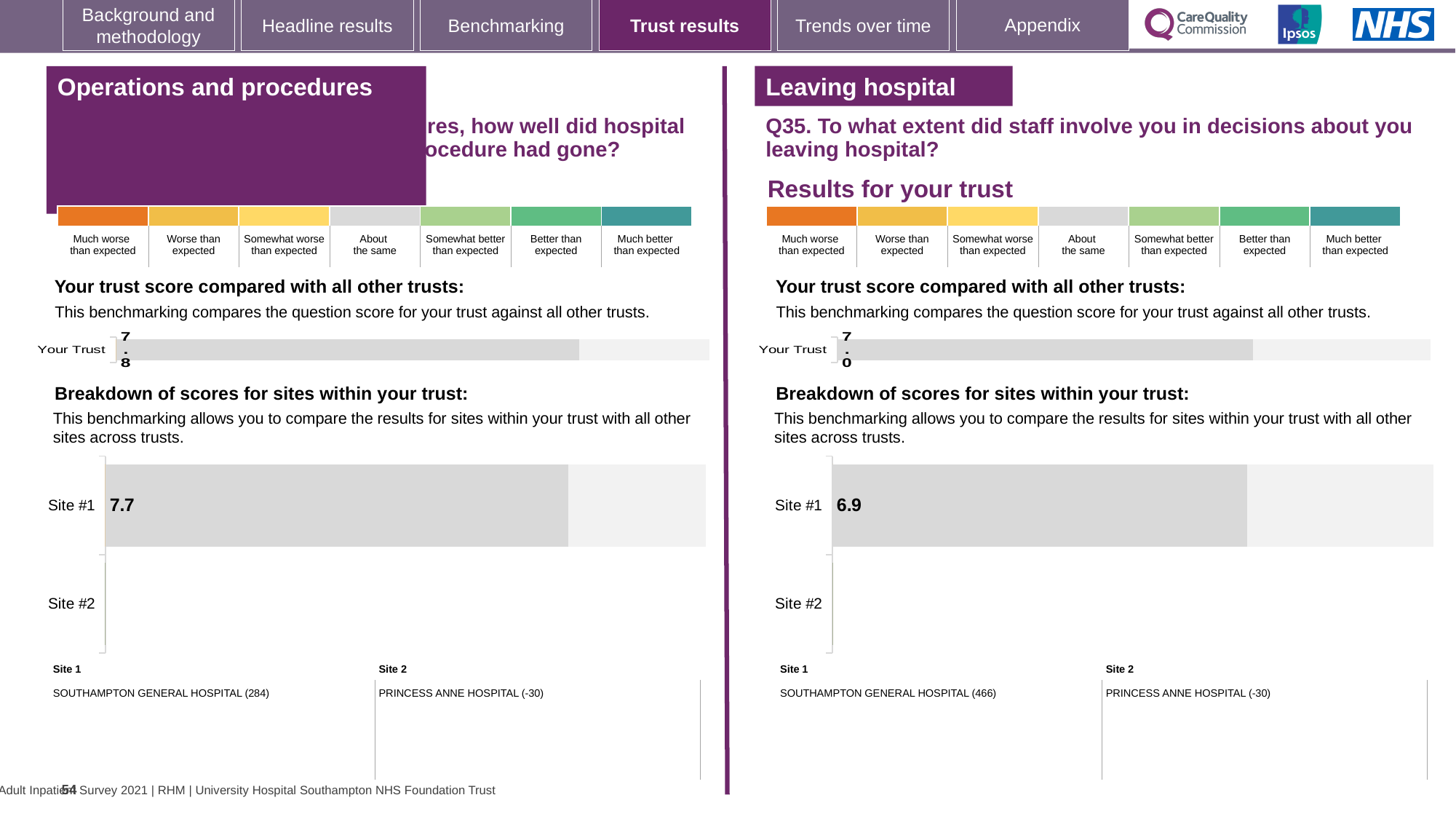
How many sites are listed in the 'Breakdown of scores for sites within your trust' chart under 'Leaving hospital'? 2 Which section shows a higher Site #1 score in its site breakdown chart, 'Operations and procedures' or 'Leaving hospital'? Operations and procedures How many rating categories, from 'Much worse than expected' to 'Much better than expected', are shown in the colour scale above each 'Your trust score' chart? 7 What is the difference between the Site #1 score in the 'Operations and procedures' breakdown chart and the Site #1 score in the 'Leaving hospital' breakdown chart? 0.8 In the 'Breakdown of scores for sites within your trust' chart under 'Operations and procedures', what is the score for Site #1? 7.7 According to the key below the 'Leaving hospital' site breakdown chart, which hospital is Site 1? Southampton General Hospital What type of chart is used to show the Site #1 and Site #2 scores in the site breakdown sections? Bar chart What is the difference between the Your Trust score for 'Operations and procedures' and the Your Trust score for 'Leaving hospital'? 0.8 On the right 'Leaving hospital' section, what is the score shown for Your Trust in the 'Your trust score compared with all other trusts' chart? 7.0 In the 'Breakdown of scores for sites within your trust' chart under 'Leaving hospital', what is the score for Site #1? 6.9 On the left 'Operations and procedures' section, what is the score shown for Your Trust in the 'Your trust score compared with all other trusts' chart? 7.8 In the 'Operations and procedures' section, which is higher: the Your Trust score or the Site #1 score? Your Trust